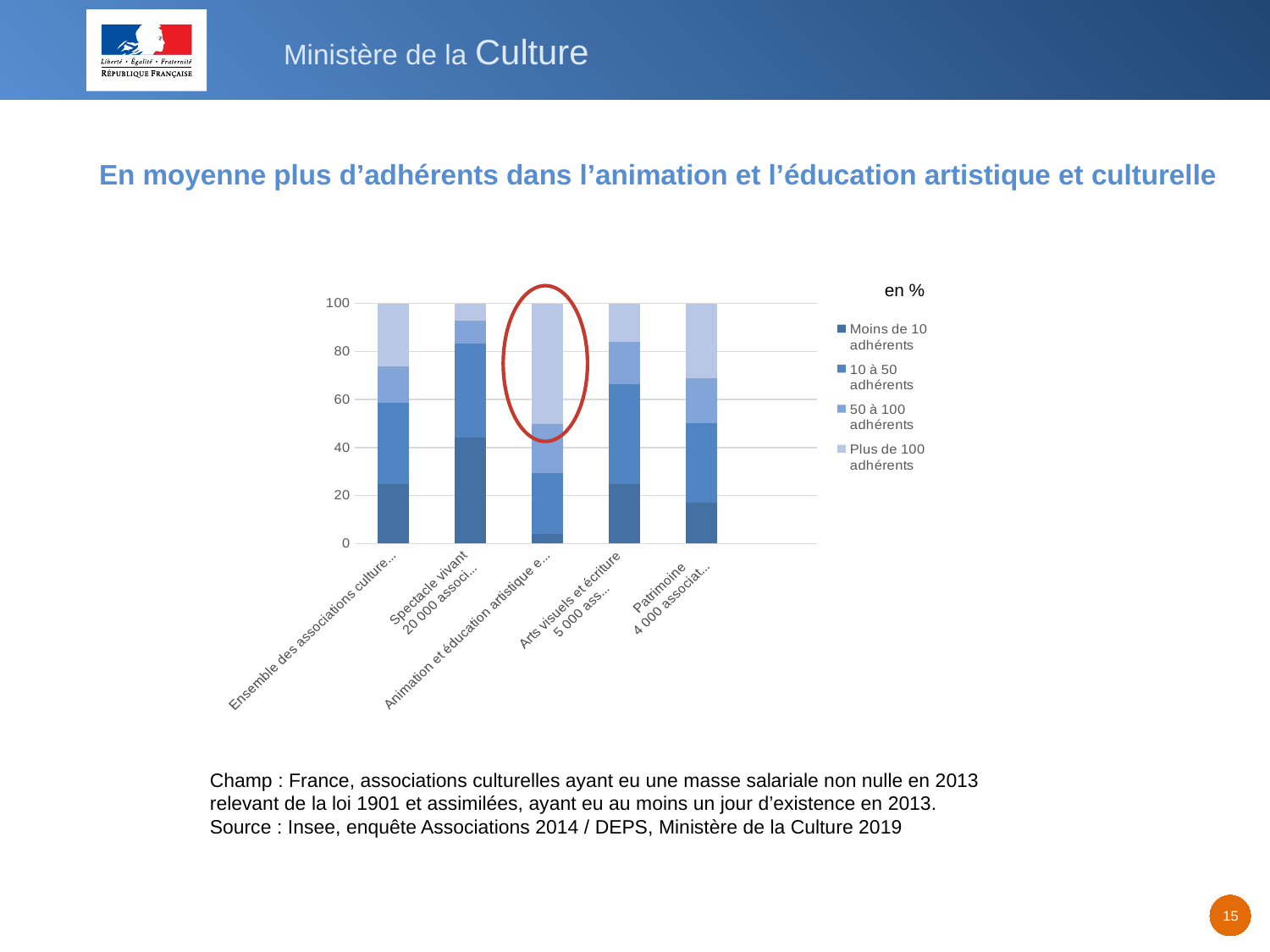
Which category has the smallest 'Plus de 100 adhérents' segment? Spectacle vivant What is the total height of each stacked bar on the axis? 100 Which category has the largest 'Moins de 10 adhérents' segment? Spectacle vivant Is the 'Moins de 10 adhérents' value for Spectacle vivant greater or less than 20? greater What kind of chart is shown on the slide? stacked bar chart Which category has the smallest 'Moins de 10 adhérents' segment? Animation et éducation artistique Which category has the largest 'Plus de 100 adhérents' segment? Animation et éducation artistique Is the 'Moins de 10 adhérents' value for Animation et éducation artistique greater or less than 20? less Which legend entry is shown in the darkest blue? Moins de 10 adhérents How many categories (bars) does the chart show? 5 How many series does the legend list? 4 What unit is indicated above the legend of the chart? en %